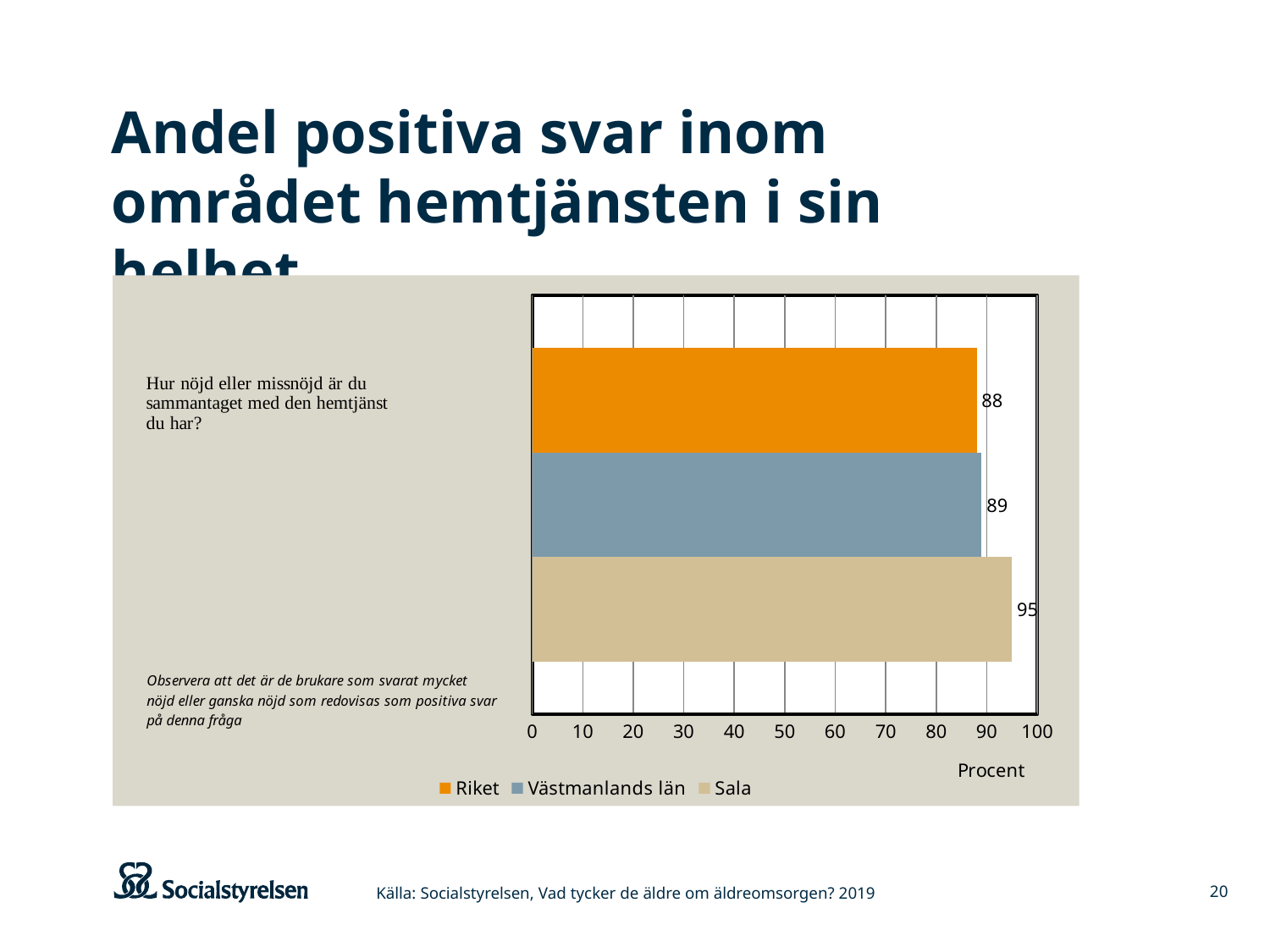
What is the value for Riket? 88 What is the label on the horizontal axis? Procent Which series has the lowest value? Riket What is the value for Sala? 95 What is the difference between the values for Västmanlands län and Riket? 1 What kind of chart is shown on the slide? Bar chart What is the difference between the values for Sala and Riket? 7 What is the value for Västmanlands län? 89 How many series does the legend list? 3 Is the value for Sala greater or less than 90? greater Which series has the highest value? Sala Which is larger, the value for Sala or the value for Västmanlands län? Sala